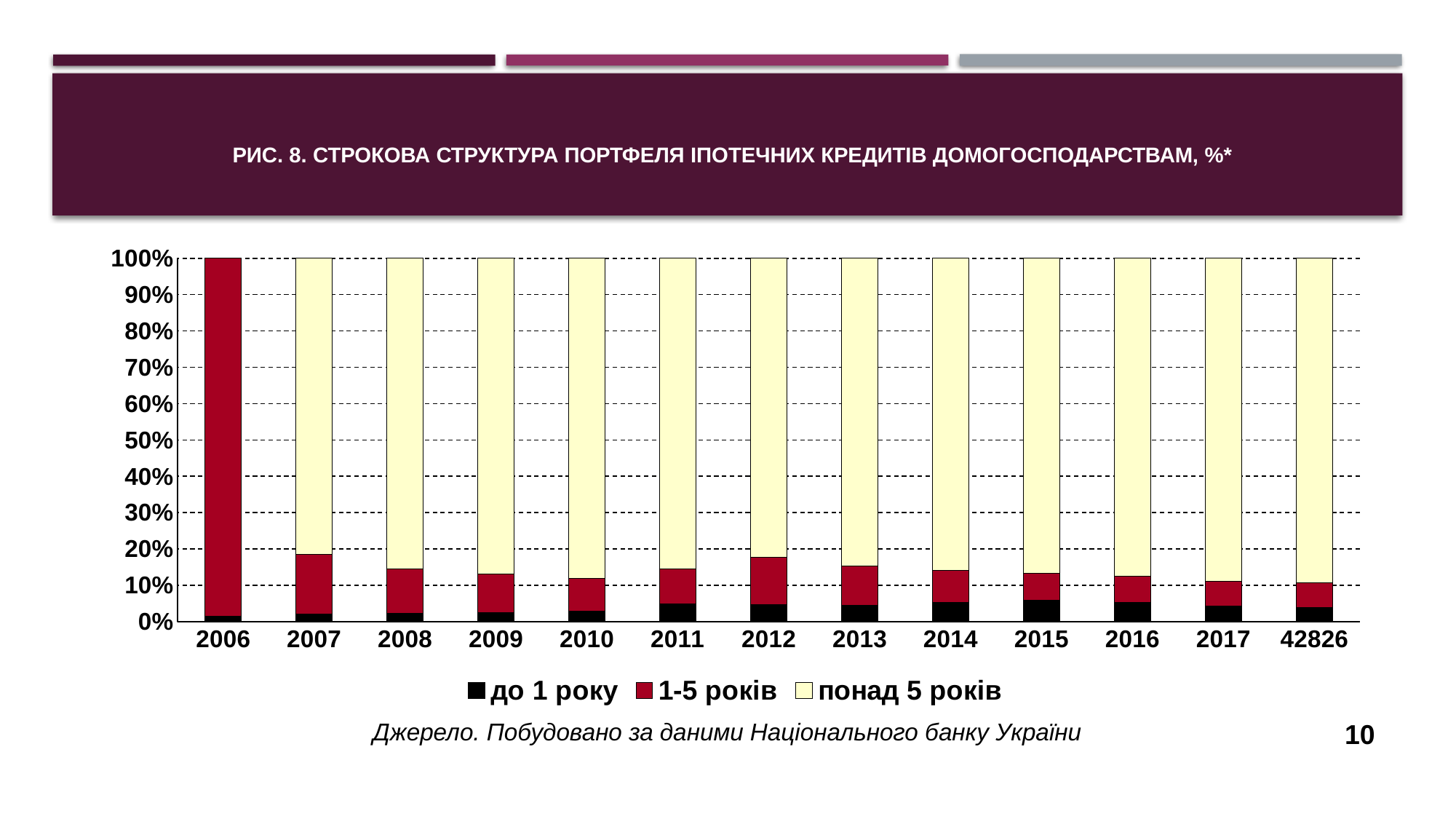
Is the share of '1-5 років' in 2006 greater or less than 90%? greater Which year has the smallest share for 'понад 5 років'? 2006 How many categories are shown on the x axis? 13 What kind of chart is shown on the slide? Stacked bar chart Which year has the larger share of 'понад 5 років', 2007 or 2017? 2017 Is the share of 'понад 5 років' in 2007 greater or less than 70%? greater What is the title of the chart? РИС. 8. СТРОКОВА СТРУКТУРА ПОРТФЕЛЯ ІПОТЕЧНИХ КРЕДИТІВ ДОМОГОСПОДАРСТВАМ, %* Is the share of 'до 1 року' in 2015 greater or less than 10%? less How many series does the legend list? 3 What is the total height of the stacked bar for 2010? 100% What are the three legend entries of the chart? до 1 року, 1-5 років, понад 5 років Which year has the largest share for '1-5 років'? 2006